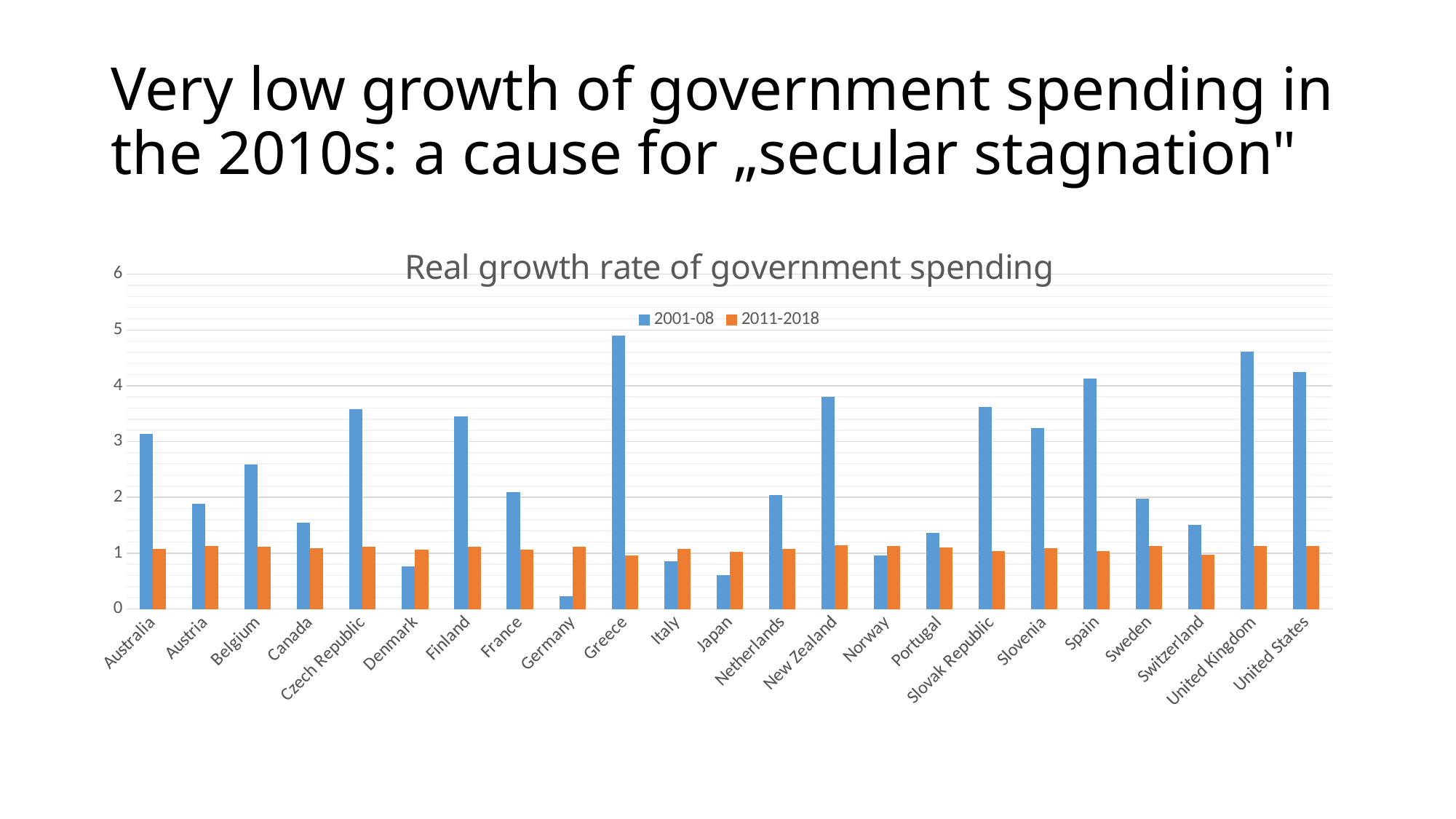
Which country has the highest value for the 2001-08 series? Greece What is the title of the chart? Real growth rate of government spending Which has the larger 2001-08 value, Australia or Austria? Australia What type of chart is shown on the slide? bar chart For Germany, which series has the larger value, 2001-08 or 2011-2018? 2011-2018 How many series does the legend list? 2 Is the 2001-08 value for Greece greater or less than 4? greater Which country has the lowest value for the 2001-08 series? Germany Is the 2001-08 value for Denmark greater or less than 1? less Is the 2001-08 value for the United States greater or less than 4? greater How many countries are shown on the x axis? 23